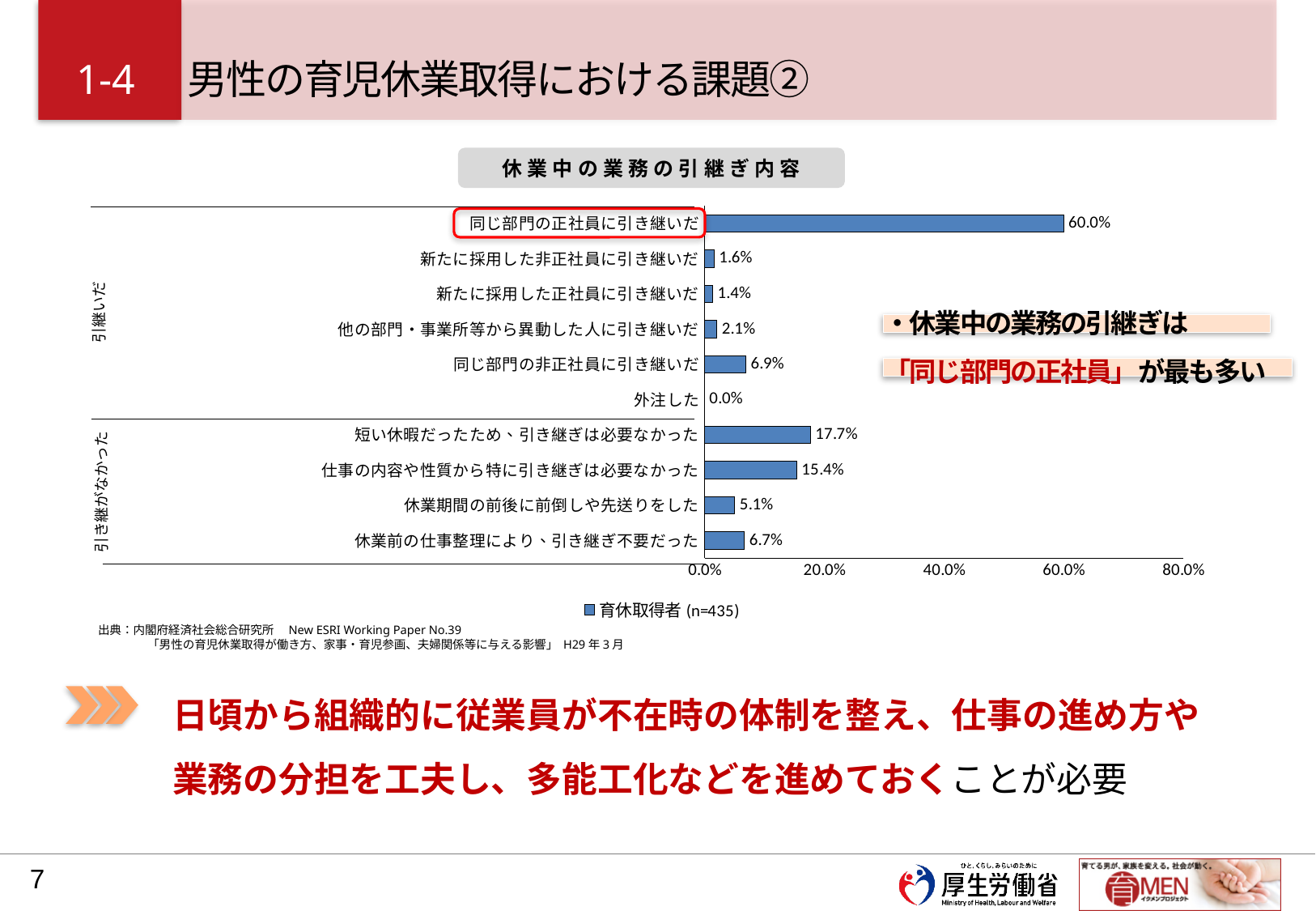
Is the value for 「同じ部門の正社員に引き継いだ」 greater or less than 40.0%? greater What is the value for 「外注した」? 0.0% What is the legend entry of the chart? 育休取得者 (n=435) What kind of chart is shown on the slide? bar chart What is the difference between 「短い休暇だったため、引き継ぎは必要なかった」 and 「仕事の内容や性質から特に引き継ぎは必要なかった」? 2.3% What is the value for 「短い休暇だったため、引き継ぎは必要なかった」? 17.7% What is the value for 「休業前の仕事整理により、引き継ぎ不要だった」? 6.7% Which is larger: 「同じ部門の非正社員に引き継いだ」 or 「休業期間の前後に前倒しや先送りをした」? 同じ部門の非正社員に引き継いだ What is the value for 「同じ部門の正社員に引き継いだ」? 60.0% Which category has the lowest value? 外注した How many categories are shown in the chart? 10 Which category has the highest value? 同じ部門の正社員に引き継いだ